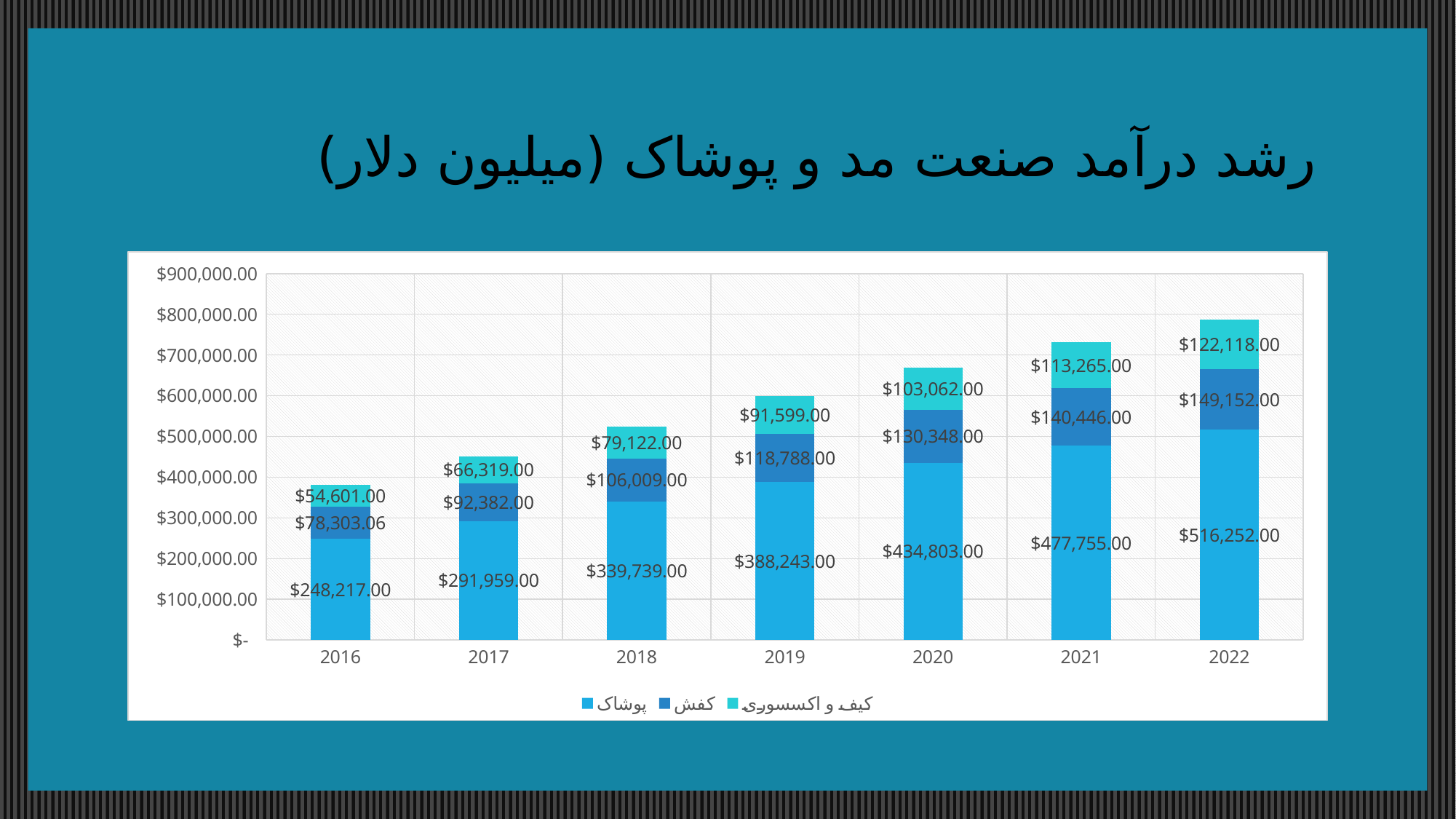
What type of chart is shown on the slide? Stacked bar chart What is the value of the کفش series for 2021? $140,446.00 How many series does the legend list? 3 In which year is the کیف و اکسسوری value lowest? 2016 Do the پوشاک values rise or fall from 2016 to 2022? Rise What is the value of the پوشاک series for 2019? $388,243.00 What is the difference between the پوشاک values for 2022 and 2016? $268,035.00 What is the value of the کیف و اکسسوری series for 2016? $54,601.00 What is the total of the stacked bar for 2022? $787,522.00 In which year is the پوشاک value highest? 2022 How many years are shown on the x axis? 7 Which is larger: the کفش value for 2018 or the کیف و اکسسوری value for 2020? کفش value for 2018